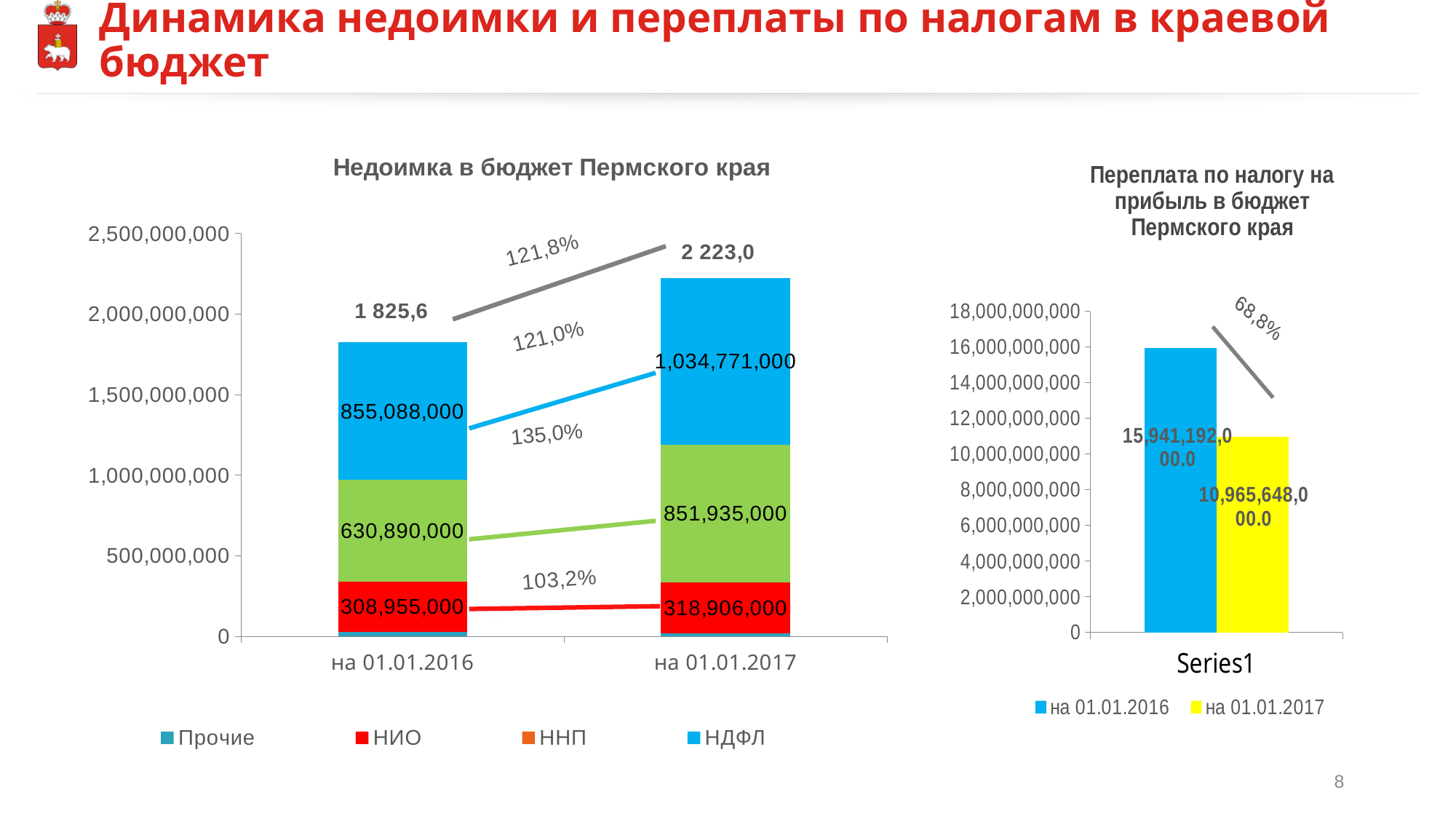
In the left chart "Недоимка в бюджет Пермского края", how many series does the legend list? 4 In the right chart "Переплата по налогу на прибыль в бюджет Пермского края", what percentage is written next to the arrow between the two bars? 68,8% In the left chart "Недоимка в бюджет Пермского края", is the НИО value larger on 01.01.2016 or on 01.01.2017? на 01.01.2017 In the left chart "Недоимка в бюджет Пермского края", how many categories are shown on the x axis? 2 In the left chart "Недоимка в бюджет Пермского края", what is the value of НИО on 01.01.2017? 318,906,000 In the left chart "Недоимка в бюджет Пермского края", by how much did НДФЛ increase from 01.01.2016 to 01.01.2017? 179,683,000 In the right chart "Переплата по налогу на прибыль в бюджет Пермского края", which date has the higher value? на 01.01.2016 In the left chart "Недоимка в бюджет Пермского края", what total is labelled above the bar for 01.01.2017? 2 223,0 In the left chart "Недоимка в бюджет Пермского края", what is the value of НДФЛ on 01.01.2016? 855,088,000 What kind of chart is the left chart titled "Недоимка в бюджет Пермского края"? Stacked bar chart In the right chart "Переплата по налогу на прибыль в бюджет Пермского края", is the value for 01.01.2017 greater or less than 12,000,000,000? less In the right chart "Переплата по налогу на прибыль в бюджет Пермского края", what is the value for 01.01.2016? 15,941,192,000.0